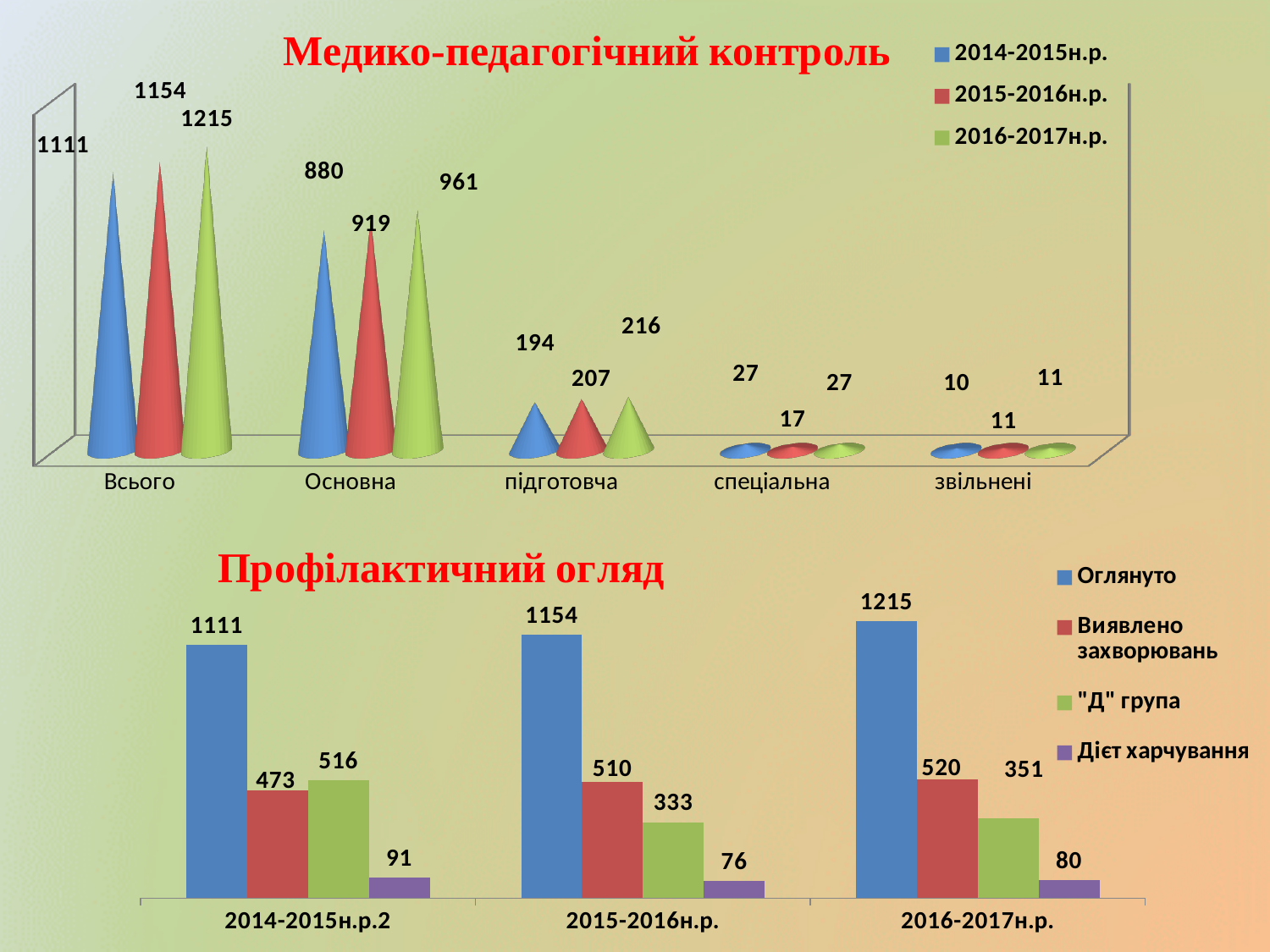
In the chart titled "Медико-педагогічний контроль", what is the difference between the 2016-2017н.р. and 2014-2015н.р. values for підготовча? 22 What kind of chart is the one titled "Профілактичний огляд"? bar chart In the chart titled "Медико-педагогічний контроль", which category has the lowest value for 2014-2015н.р.? звільнені In the chart titled "Профілактичний огляд", what is the difference between Оглянуто in 2016-2017н.р. and Оглянуто in 2014-2015н.р.2? 104 In the chart titled "Медико-педагогічний контроль", what is the value for спеціальна in 2015-2016н.р.? 17 In the chart titled "Медико-педагогічний контроль", what is the value for Всього in 2016-2017н.р.? 1215 In the chart titled "Медико-педагогічний контроль", how many categories are shown on the x axis? 5 In the chart titled "Медико-педагогічний контроль", what is the value for Основна in 2014-2015н.р.? 880 In the chart titled "Профілактичний огляд", what is the value for "Д" група in 2015-2016н.р.? 333 In the chart titled "Профілактичний огляд", which is larger: Виявлено захворювань in 2016-2017н.р. or "Д" група in 2016-2017н.р.? Виявлено захворювань In the chart titled "Медико-педагогічний контроль", how many series does the legend list? 3 In the chart titled "Профілактичний огляд", what is the value for Дієт харчування in 2014-2015н.р.2? 91